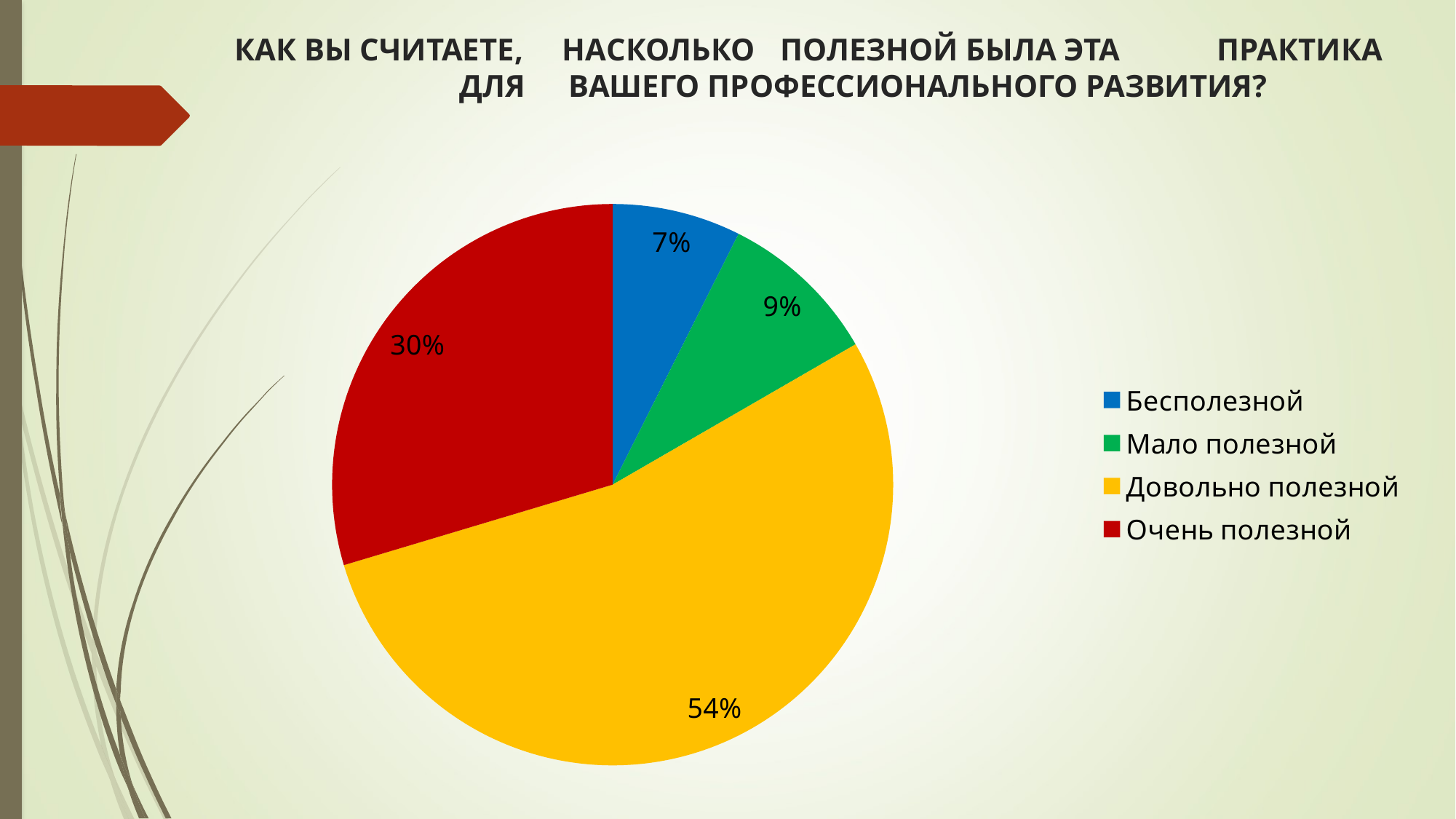
Which category has the largest slice? Довольно полезной What colour is the slice for "Очень полезной"? red What share of the pie does "Довольно полезной" take? 54% Which category has the smallest slice? Бесполезной How many categories does the pie chart have? 4 What share of the pie does "Очень полезной" take? 30% What kind of chart is shown on the slide? pie chart What is the value for "Мало полезной"? 9% Which is larger, the share for "Мало полезной" or the share for "Бесполезной"? Мало полезной What is the combined share of "Бесполезной" and "Мало полезной"? 16% What is the value for "Бесполезной"? 7% What is the difference between the shares for "Довольно полезной" and "Очень полезной"? 24%